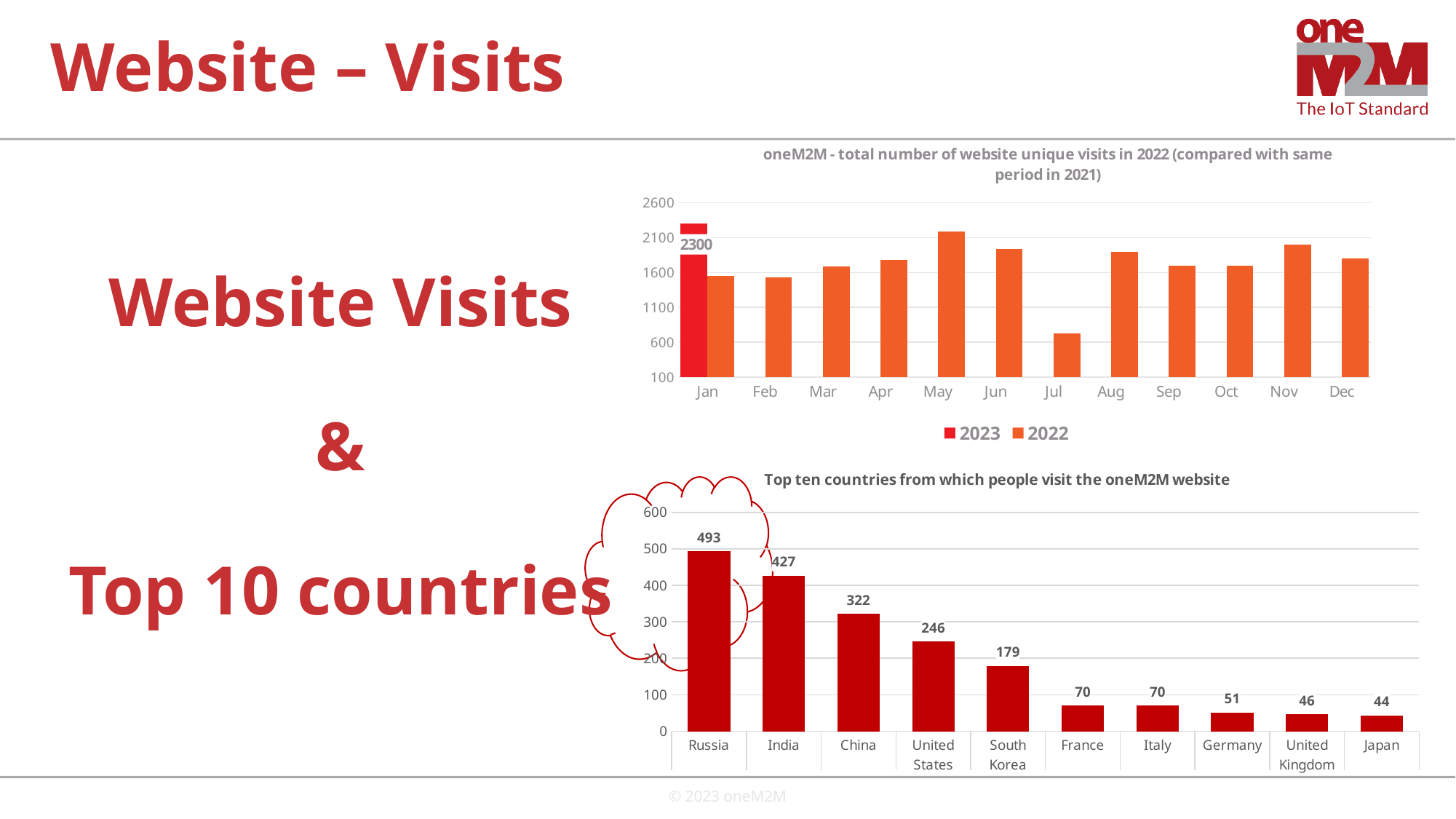
In the top chart, which month has the lowest 2022 value? Jul In the top chart, what is the value for Jan in the 2023 series? 2300 In the bottom chart, how many countries are shown? 10 In the top chart, how many series does the legend list? 2 In the top chart, which month has the highest 2022 value? May In the top chart, is the 2022 value for Jul greater or less than 1100? less In the bottom chart, how many visits come from India? 427 In the bottom chart, what is the difference between the values for Russia and India? 66 In the bottom chart, which is larger, the value for China or the value for United States? China In the top chart, is the 2022 value for May greater or less than 1600? greater In the bottom chart, which country has the highest value? Russia In the bottom chart, which country has the lowest value? Japan